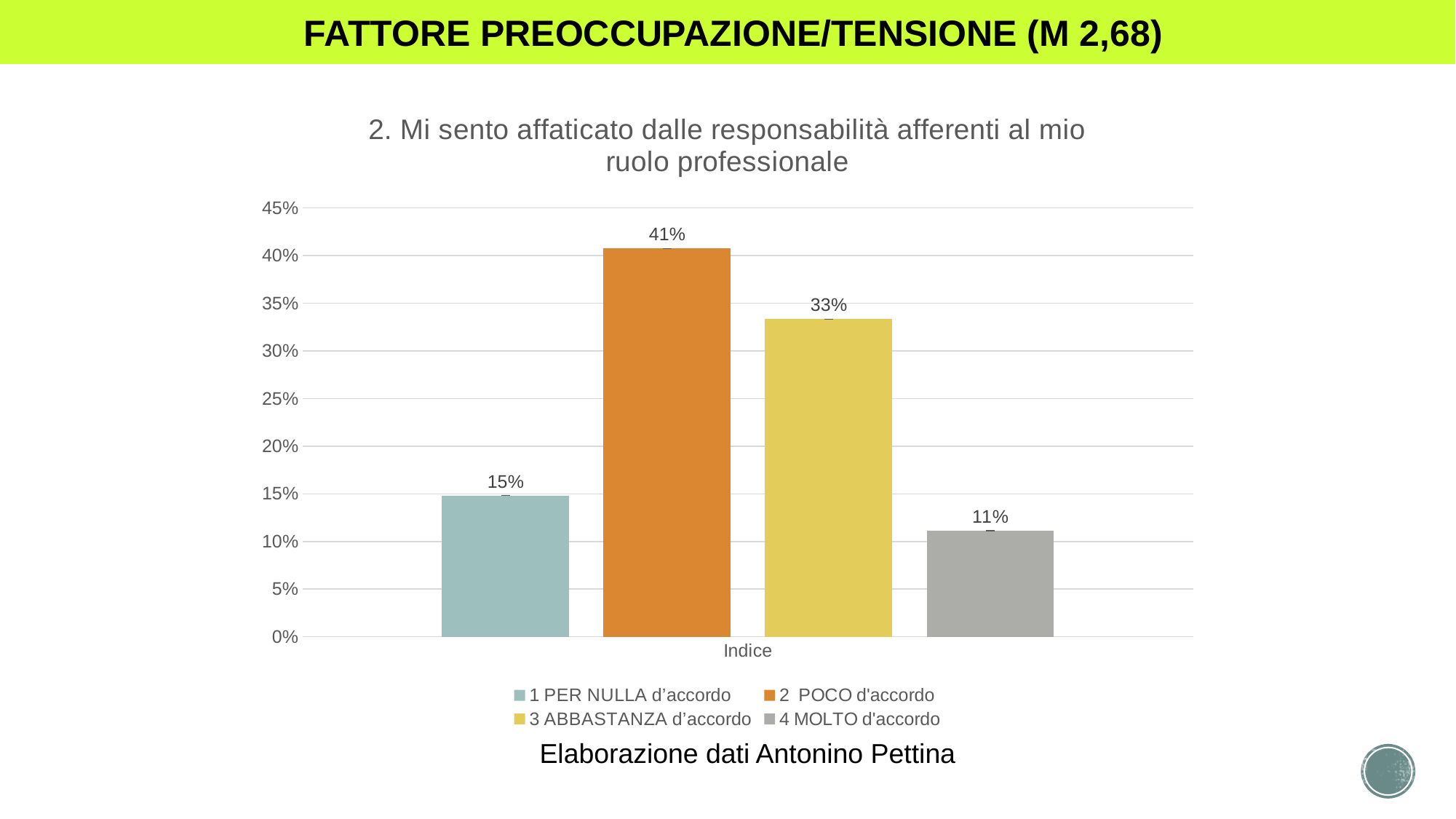
What is the value for "1 PER NULLA d'accordo"? 15% Which series has the highest value? 2 POCO d'accordo Which series has the lowest value? 4 MOLTO d'accordo Is the value for "3 ABBASTANZA d'accordo" greater or less than 30%? greater What is the value for "3 ABBASTANZA d'accordo"? 33% How many series does the legend list? 4 What kind of chart is shown on the slide? bar chart What is the value for "4 MOLTO d'accordo"? 11% What is the difference between the values for "2 POCO d'accordo" and "3 ABBASTANZA d'accordo"? 8% What is the value for "2 POCO d'accordo"? 41% Which is larger, the value for "1 PER NULLA d'accordo" or "4 MOLTO d'accordo"? 1 PER NULLA d'accordo What is the title of the chart? 2. Mi sento affaticato dalle responsabilità afferenti al mio ruolo professionale